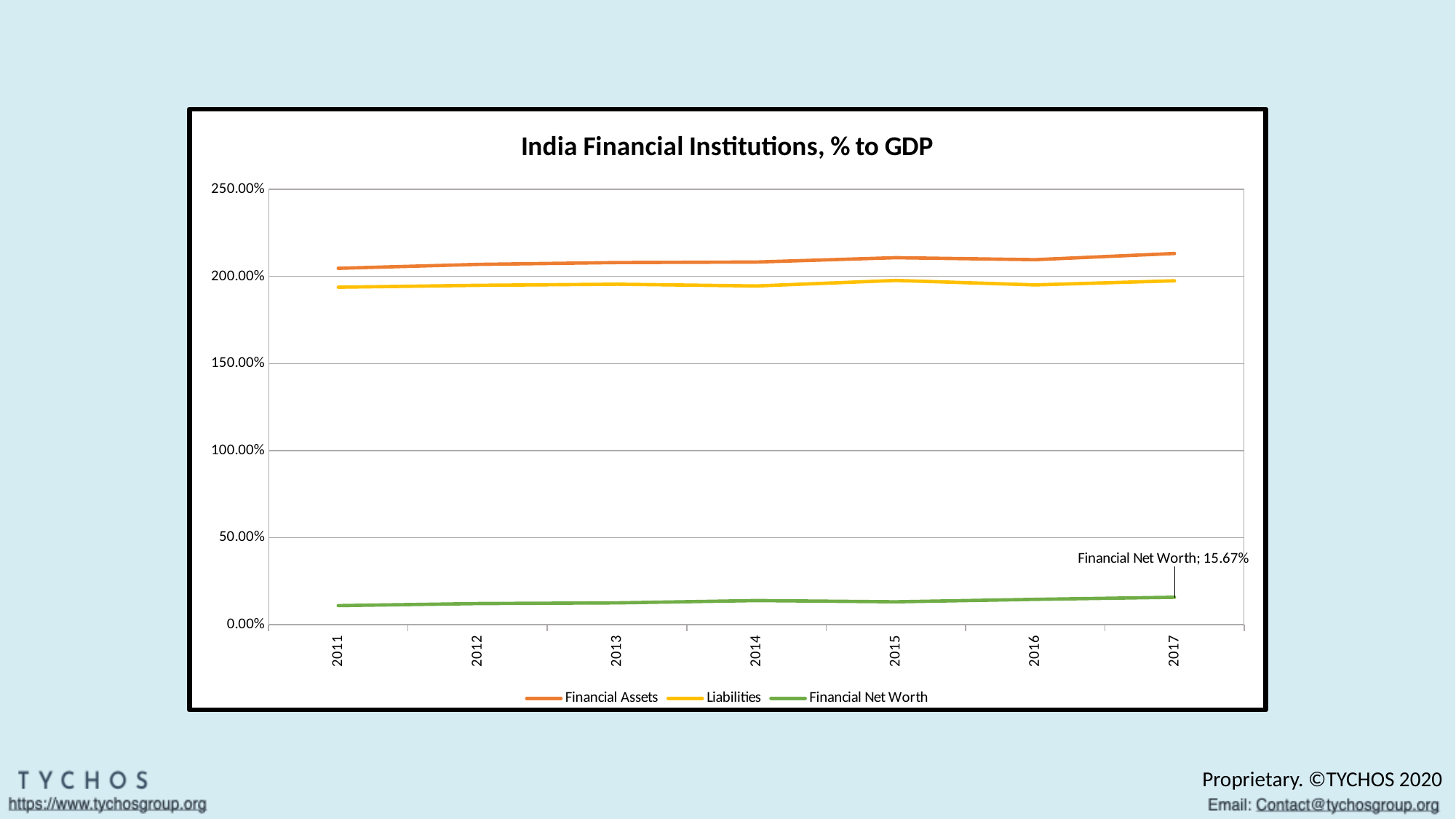
Which series has the highest values across all years? Financial Assets What is the title of the chart? India Financial Institutions, % to GDP What is the value of Financial Net Worth in 2017? 15.67% Which series has the lowest values across all years? Financial Net Worth Is the value for Financial Net Worth in 2011 greater or less than 50.00%? less Does the Financial Assets line generally rise or fall from 2011 to 2017? rise How many series does the legend list? 3 What kind of chart is shown on the slide? line chart How many years are plotted along the x axis? 7 In 2015, which is larger: Financial Assets or Liabilities? Financial Assets Is the value for Financial Assets in 2017 greater or less than 200.00%? greater Is the value for Liabilities in 2011 greater or less than 200.00%? less